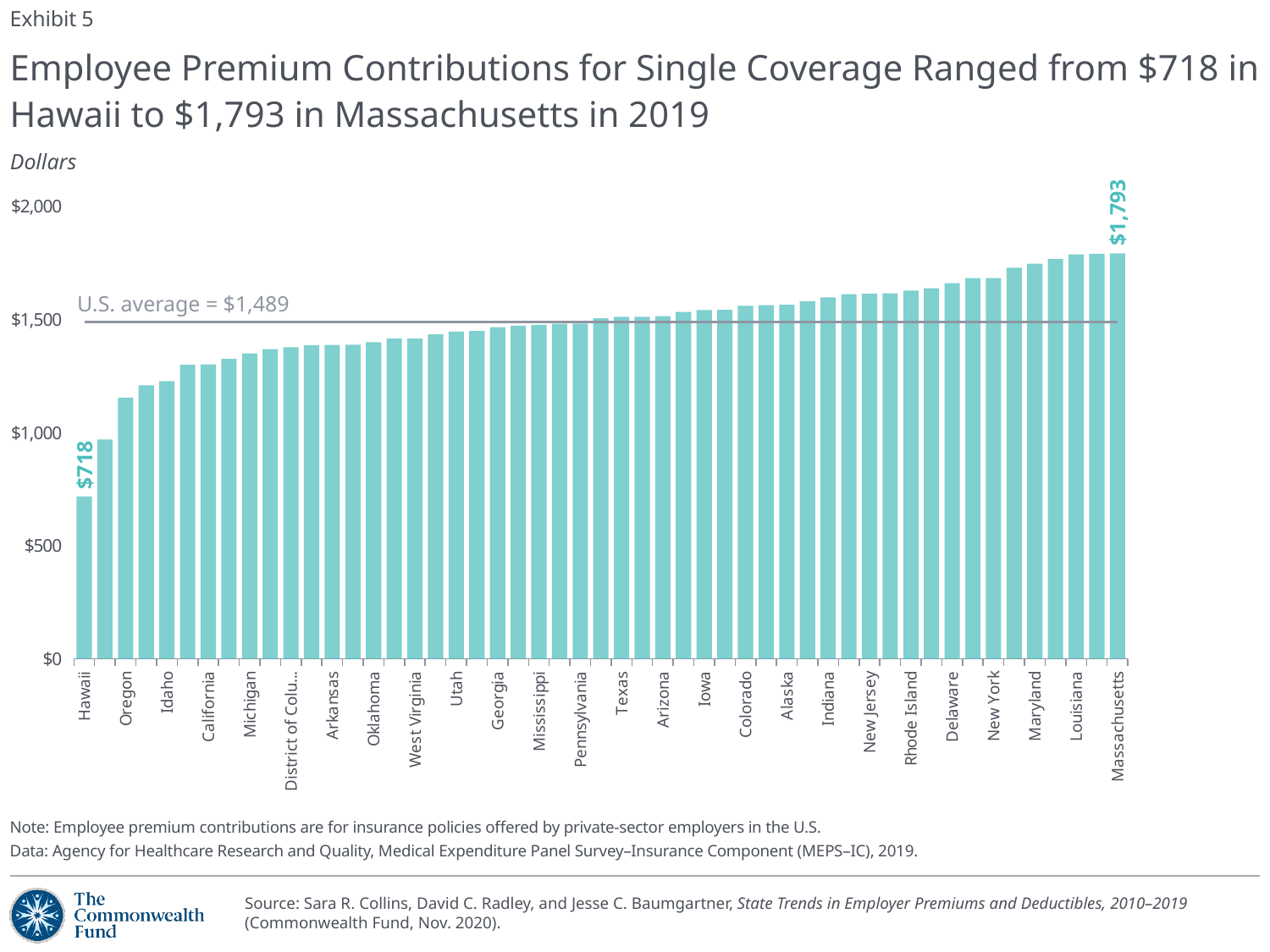
What kind of chart is shown on the slide? Bar chart Is the value for Maryland greater or less than $1,500? greater What is the difference between the employee premium contributions in Massachusetts and Hawaii? $1,075 What is the employee premium contribution for single coverage in Massachusetts? $1,793 Which state has the lowest employee premium contribution for single coverage? Hawaii What is the U.S. average employee premium contribution shown on the chart? $1,489 Is the value for California greater or less than $1,500? less Which has a larger employee premium contribution, Oregon or Maryland? Maryland Is the value for Oregon greater or less than $1,000? greater Do the values rise or fall moving from left to right along the x axis? Rise Which state has the highest employee premium contribution for single coverage? Massachusetts What is the employee premium contribution for single coverage in Hawaii? $718